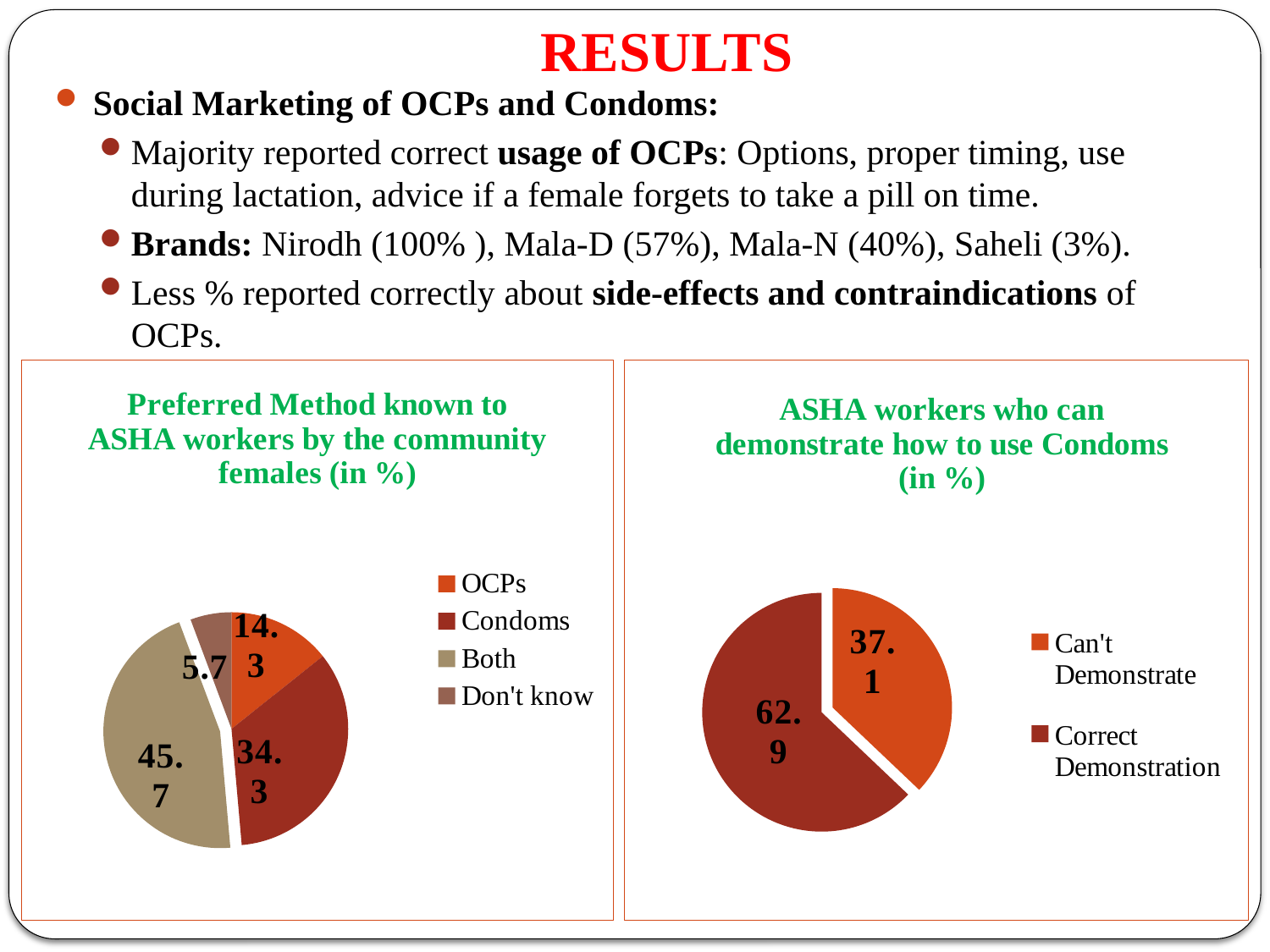
In the 'ASHA workers who can demonstrate how to use Condoms' chart, what is the value for Correct Demonstration? 62.9 In the 'Preferred Method known to ASHA workers by the community females' chart, which category has the largest slice? Both In the 'Preferred Method known to ASHA workers by the community females' chart, which category has the smallest slice? Don't know In the 'ASHA workers who can demonstrate how to use Condoms' chart, what is the value for Can't Demonstrate? 37.1 In the 'Preferred Method known to ASHA workers by the community females' chart, how many categories does the legend list? 4 In the 'Preferred Method known to ASHA workers by the community females' chart, what is the value for Don't know? 5.7 In the 'ASHA workers who can demonstrate how to use Condoms' chart, which is larger: Can't Demonstrate or Correct Demonstration? Correct Demonstration In the 'Preferred Method known to ASHA workers by the community females' chart, what is the value for Both? 45.7 What type of chart is used for 'ASHA workers who can demonstrate how to use Condoms'? Pie chart In the 'Preferred Method known to ASHA workers by the community females' chart, what is the difference between the values for Condoms and OCPs? 20 In the 'Preferred Method known to ASHA workers by the community females' chart, what is the value for OCPs? 14.3 In the 'ASHA workers who can demonstrate how to use Condoms' chart, what is the difference between Correct Demonstration and Can't Demonstrate? 25.8